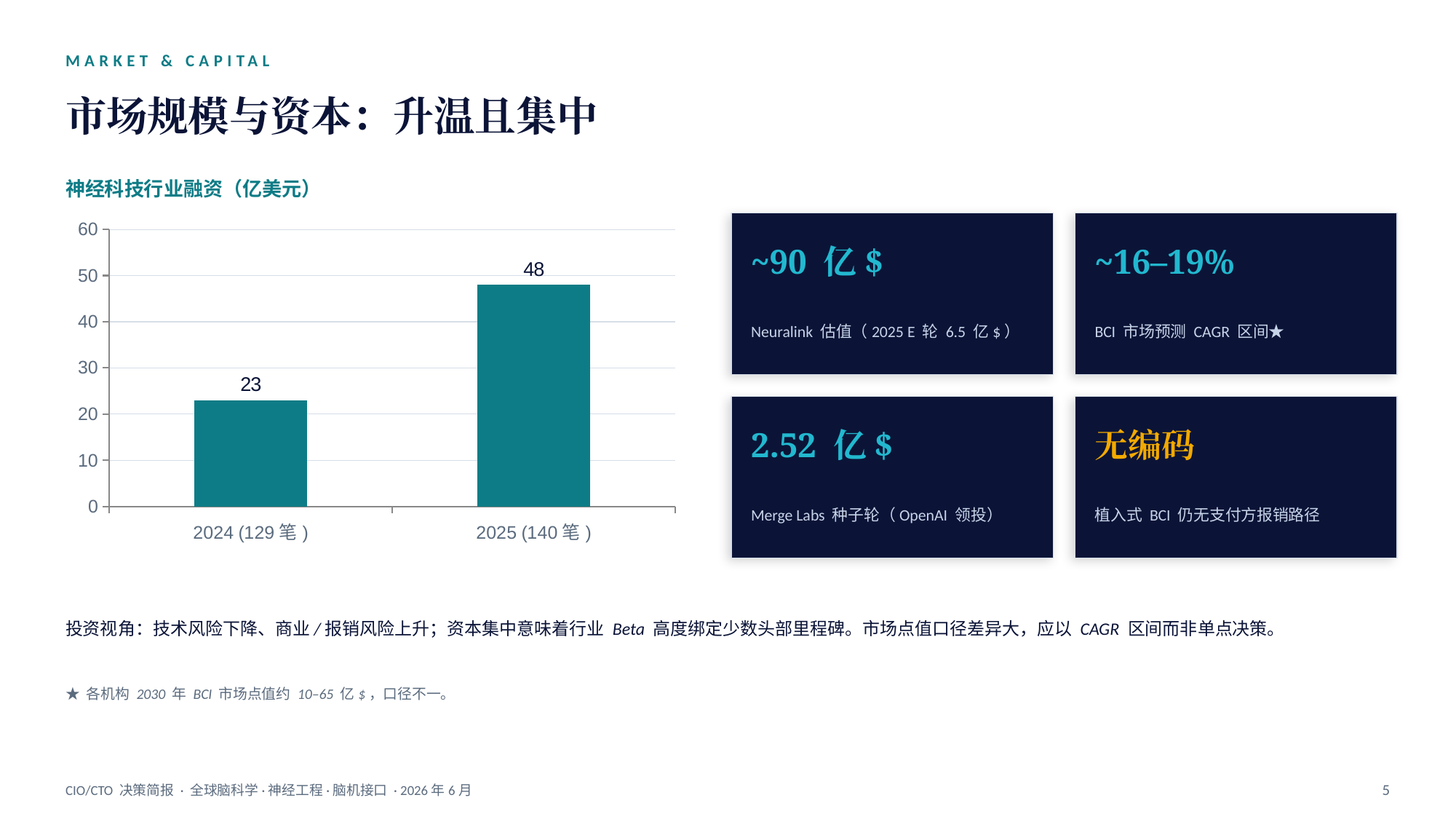
What kind of chart is the 神经科技行业融资 chart? bar chart Do the values rise or fall from 2024 to 2025 in the 神经科技行业融资 chart? rise Which is larger in the 神经科技行业融资 chart, the value for 2024 or the value for 2025? 2025 Is the value for 2024 (129 笔) greater or less than 30? less Which category has the highest value in the 神经科技行业融资 chart? 2025 (140 笔) How many categories are shown on the x axis of the 神经科技行业融资 chart? 2 Which category has the lowest value in the 神经科技行业融资 chart? 2024 (129 笔) Is the value for 2025 (140 笔) greater or less than 40? greater What is the title of the chart on the slide? 神经科技行业融资（亿美元） What is the difference between the 2025 and 2024 values in the 神经科技行业融资 chart? 25 What is the value for 2025 (140 笔) in the 神经科技行业融资 chart? 48 What is the value for 2024 (129 笔) in the 神经科技行业融资 chart? 23